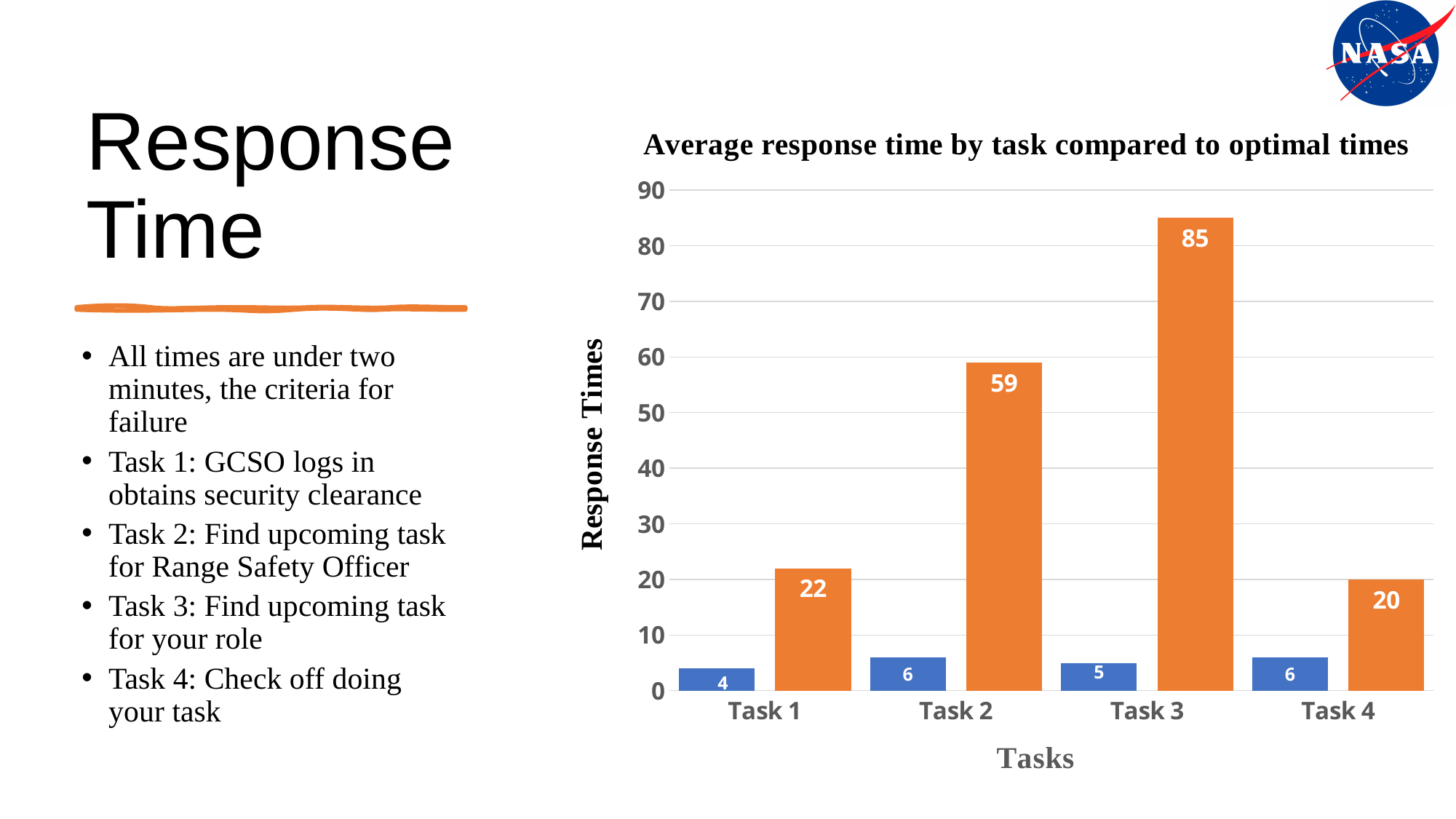
What kind of chart is shown on the slide? Bar chart What is the value of the orange bar for Task 3? 85 What is the value of the orange bar for Task 4? 20 Which is larger, the orange bar for Task 1 or the orange bar for Task 4? Task 1 What is the title of the chart? Average response time by task compared to optimal times How many tasks are shown on the x axis? 4 What is the difference between the orange bar and the blue bar for Task 2? 53 Which task has the lowest orange bar? Task 4 Which task has the highest orange bar? Task 3 Which task has the lowest blue bar? Task 1 What is the difference between the orange bars for Task 3 and Task 1? 63 What is the value of the blue bar for Task 1? 4